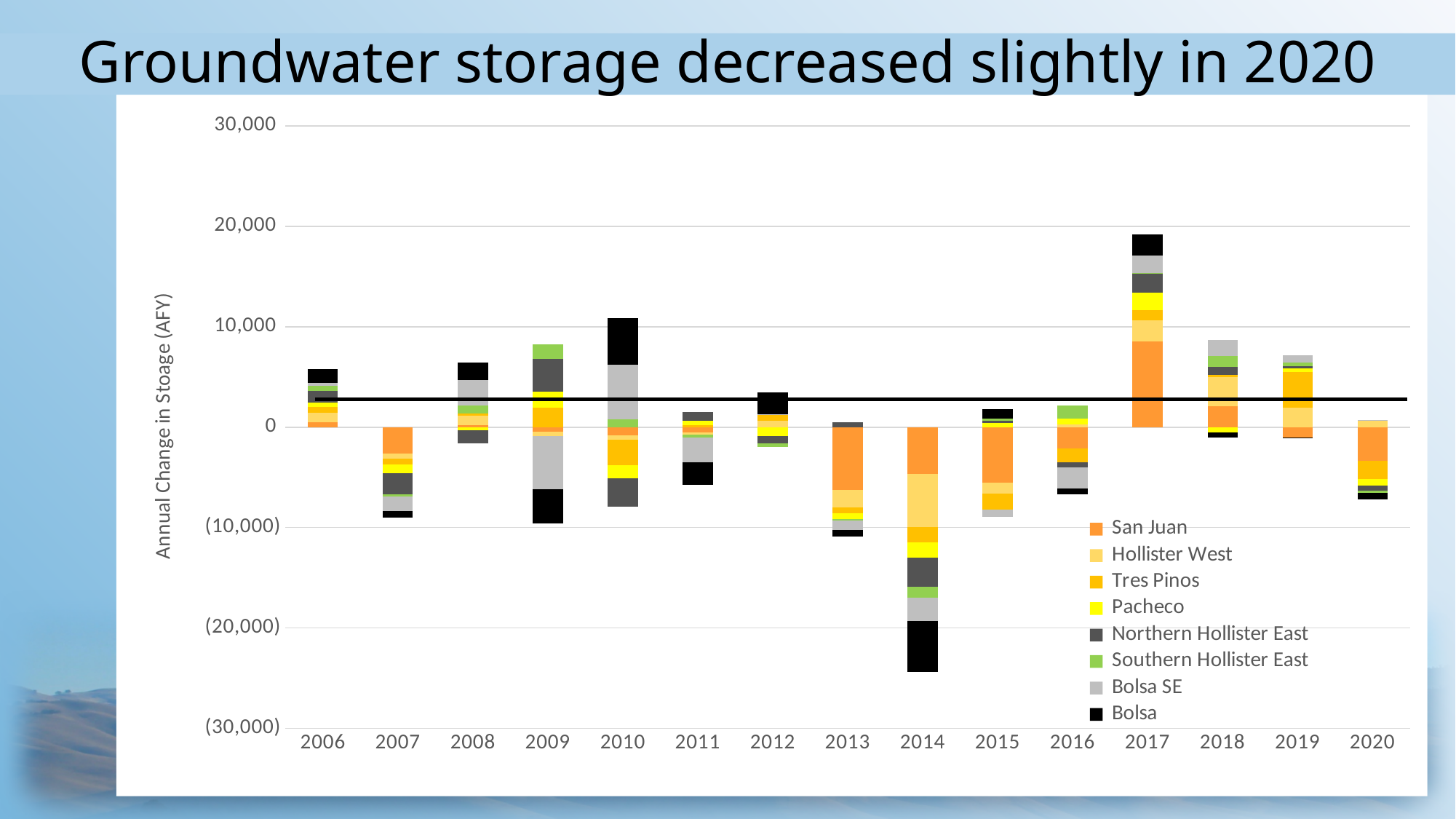
Is the top of the positive stacked bar for 2009 greater or less than 10,000? less Which year has the tallest positive stacked bar in the chart? 2017 Which year's stacked bar extends further below zero, 2013 or 2014? 2014 Is the bottom of the negative stacked bar for 2014 greater or less than (20,000)? less How many years are shown along the x axis of the chart? 15 What is the title of the slide containing the chart? Groundwater storage decreased slightly in 2020 Which year has the larger positive stacked bar, 2017 or 2018? 2017 How many series does the chart's legend list? 8 What kind of chart is shown on the slide? Stacked bar chart Is the top of the positive stacked bar for 2017 greater or less than 10,000? greater Which series is shown in black in the chart's legend? Bolsa Which year has the stacked bar extending furthest below zero? 2014